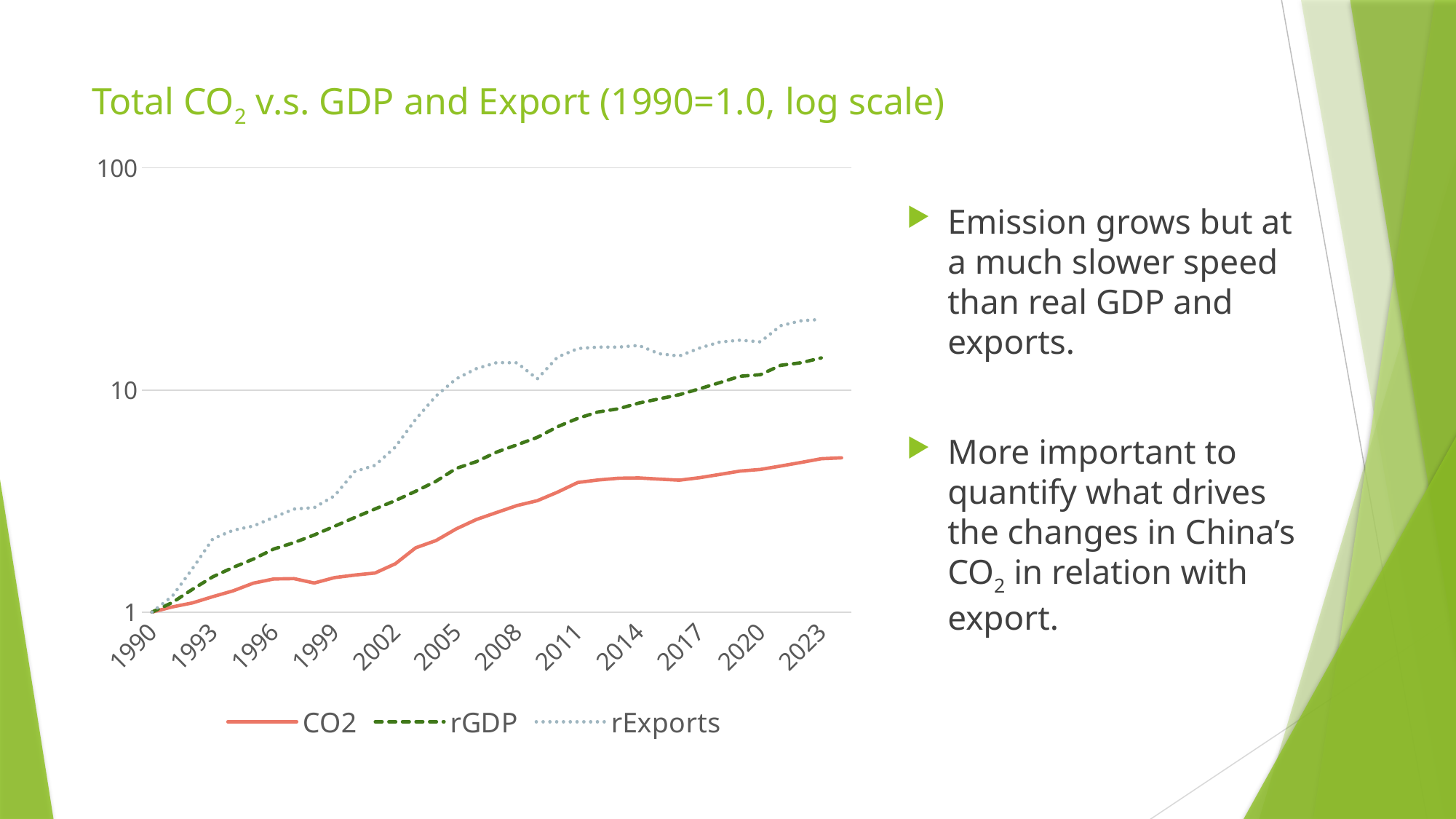
What kind of chart is shown on the slide? line chart Is the value for rGDP in 2011 greater or less than 10? less In 2014, which is larger, rGDP or CO2? rGDP Is the value for rGDP in 2023 greater or less than 10? greater What is the title of the chart? Total CO2 v.s. GDP and Export (1990=1.0, log scale) Is the value for rExports in 2008 greater or less than 10? greater What is the value of the CO2 series in 1990? 1 How many series does the legend list? 3 Which series has the highest value in 2023? rExports Which series has the lowest value in 2023? CO2 Does the CO2 series generally rise or fall from 1990 to 2023? rise